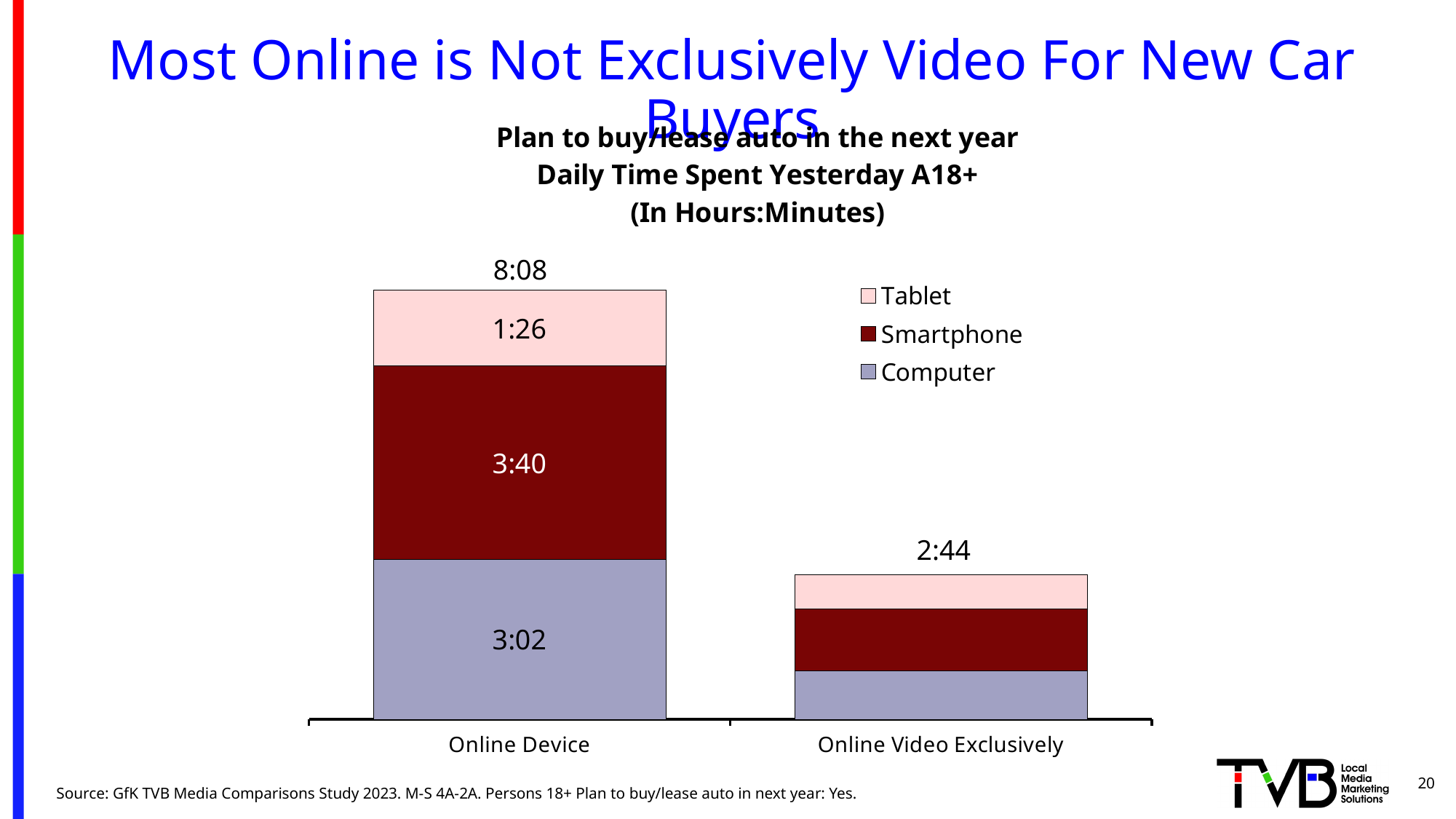
Which device accounts for the least time in the Online Device bar? Tablet Which device accounts for the most time in the Online Device bar? Smartphone How much time is spent on Tablet in the Online Device bar? 1:26 What is the difference between the Online Device total and the Online Video Exclusively total? 5:24 Which category has the larger total, Online Device or Online Video Exclusively? Online Device How much time is spent on Smartphone in the Online Device bar? 3:40 What is the total daily time spent for Online Device? 8:08 How many series does the legend list? 3 What kind of chart is shown on the slide? Stacked bar chart How many categories are shown on the x axis? 2 What is the total daily time spent for Online Video Exclusively? 2:44 How much time is spent on Computer in the Online Device bar? 3:02